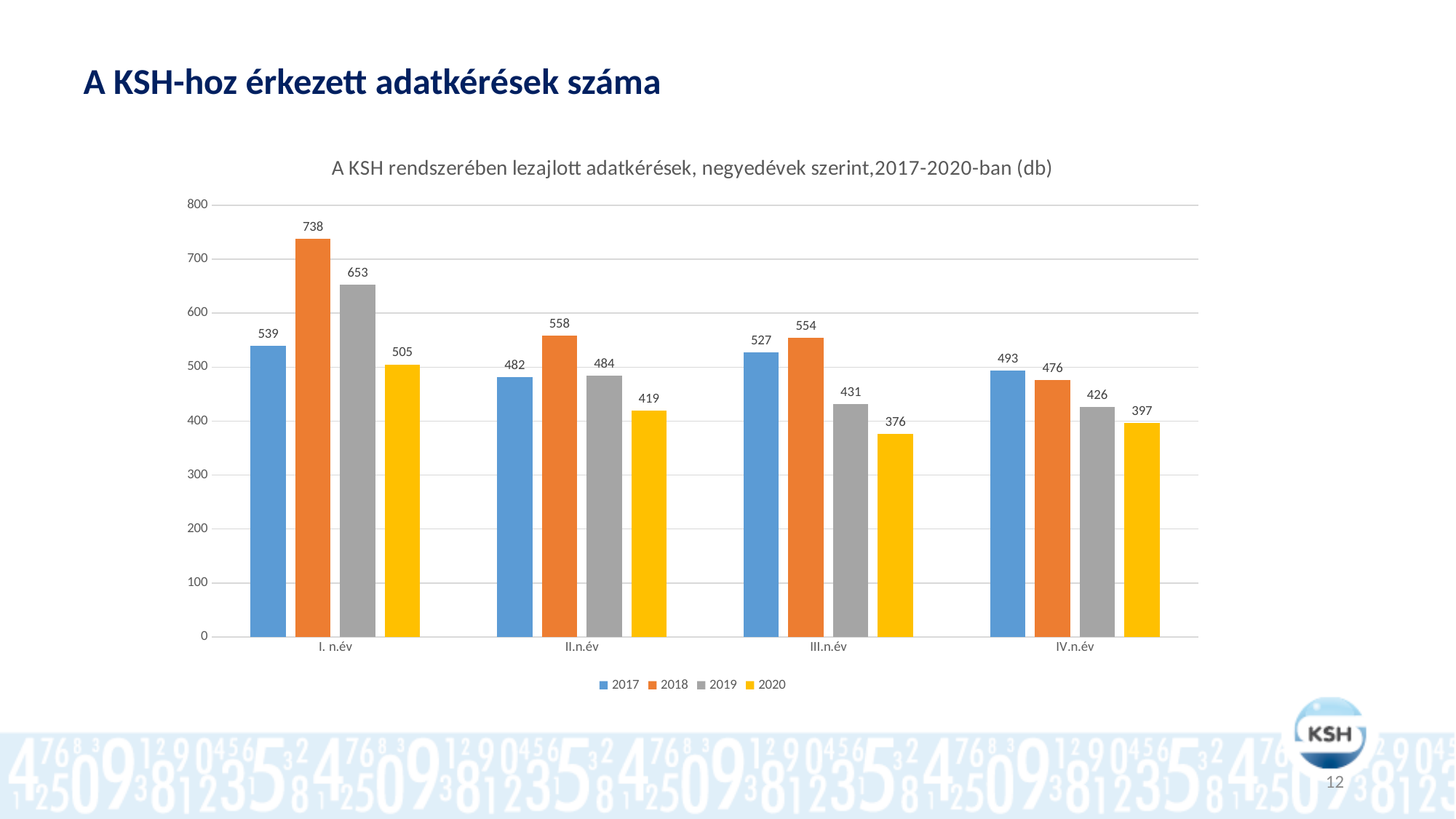
Do the values for the 2020 series rise or fall from I. n.év to III.n.év? fall What is the value for 2018 in I. n.év? 738 How many series does the legend list? 4 What is the difference between the 2018 and 2017 values in I. n.év? 199 Which quarter has the lowest value for the 2020 series? III.n.év How many quarters (categories) are shown on the x axis? 4 Which is larger in IV.n.év: the 2017 value or the 2018 value? 2017 Is the value for 2019 in II.n.év greater or less than 500? less What is the value for 2020 in III.n.év? 376 What kind of chart is shown on the slide? bar chart Which quarter has the highest value for the 2019 series? I. n.év What is the value for 2017 in IV.n.év? 493